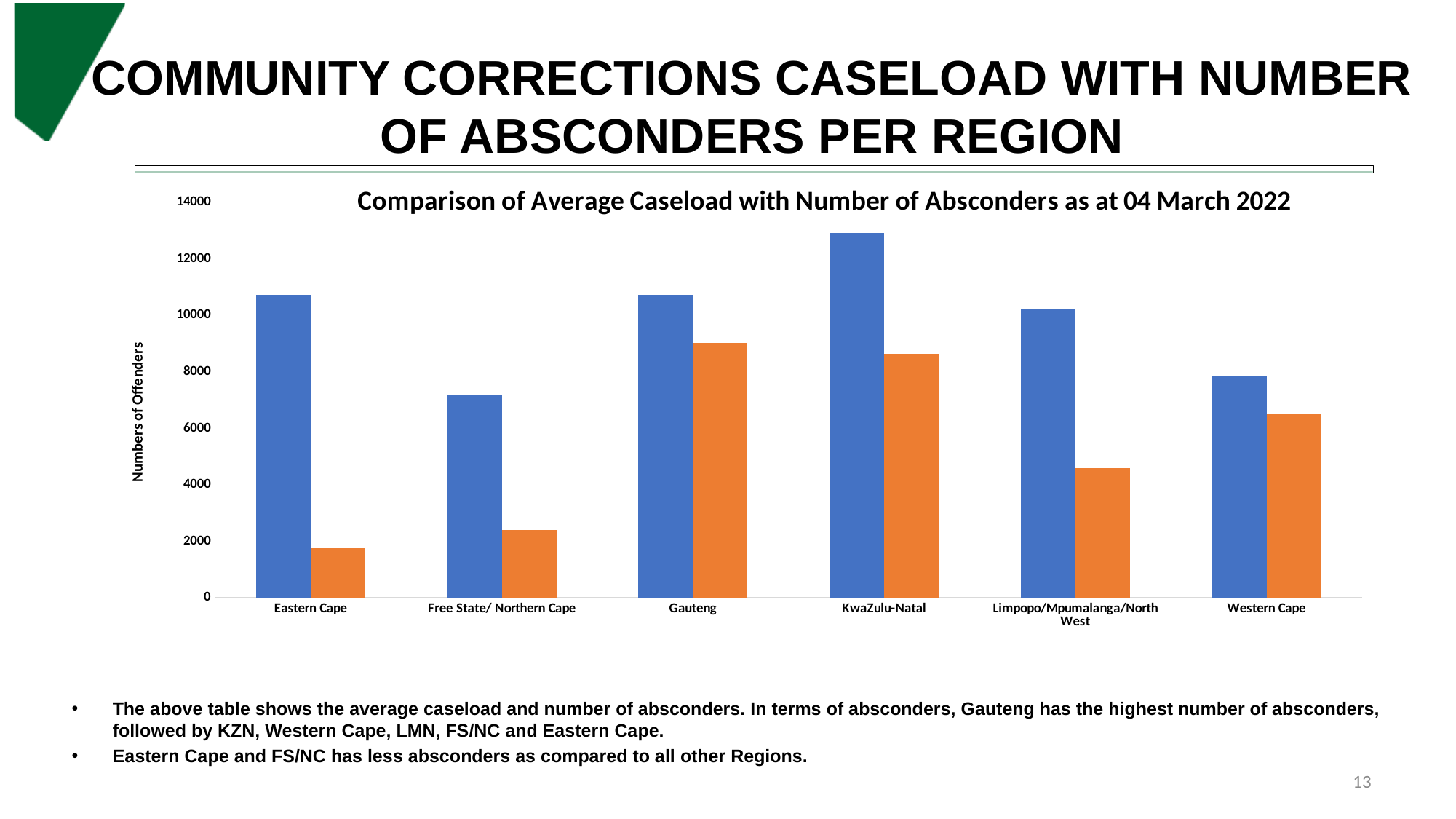
Is the value of the orange bar for Eastern Cape greater or less than 2000? less Which region has the tallest blue bar? KwaZulu-Natal How many regions are shown on the x axis of the chart? 6 Which region has the tallest orange bar? Gauteng Is the value of the orange bar for Limpopo/Mpumalanga/North West greater or less than 4000? greater Is the value of the blue bar for KwaZulu-Natal greater or less than 12000? greater Which region has the larger blue bar, Limpopo/Mpumalanga/North West or Western Cape? Limpopo/Mpumalanga/North West Which region has the shortest orange bar? Eastern Cape Which region has the shortest blue bar? Free State/ Northern Cape What is the title of the chart? Comparison of Average Caseload with Number of Absconders as at 04 March 2022 What kind of chart is shown on the slide? bar chart